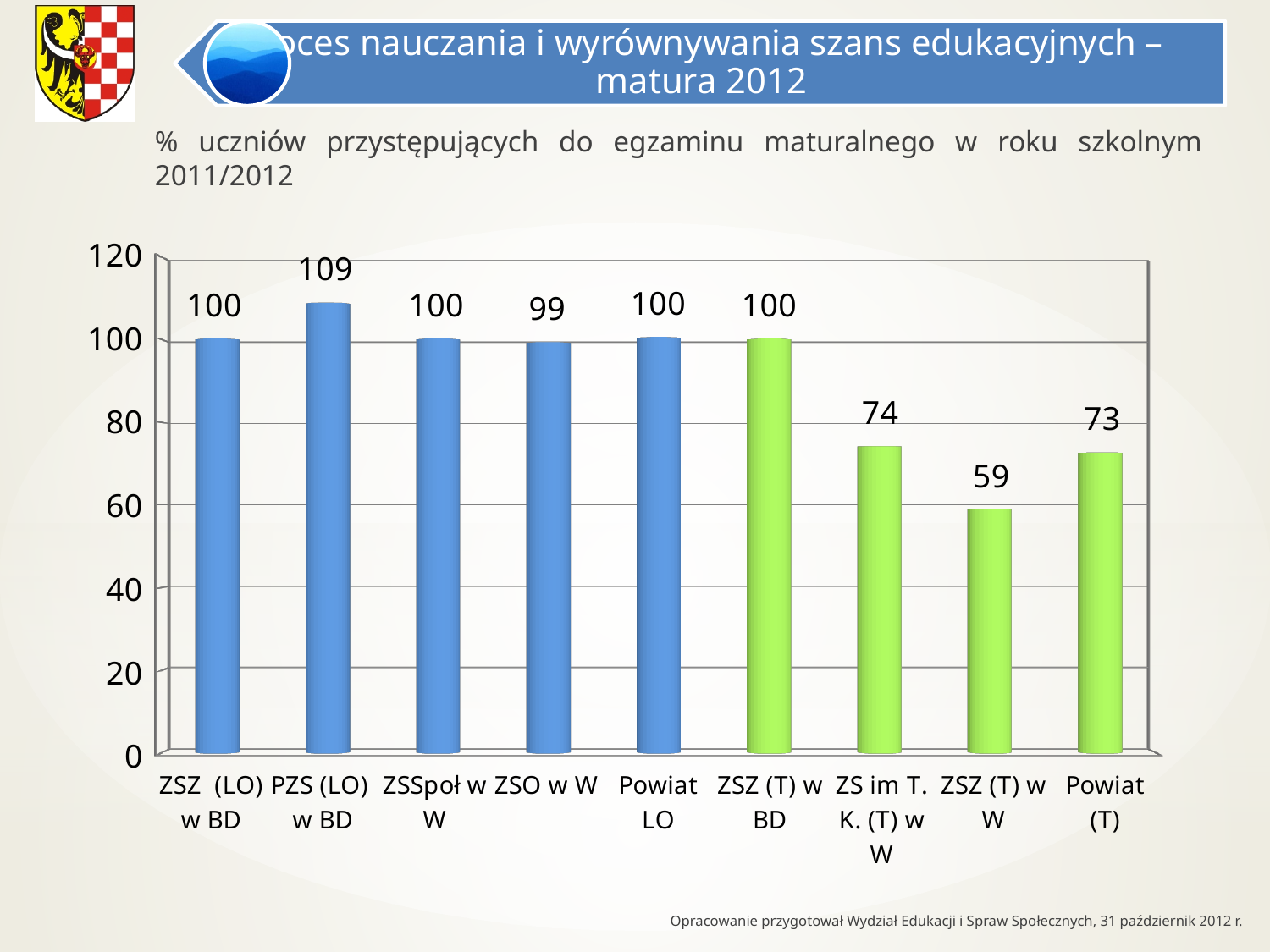
What is the value for ZSZ (T) w W? 59 Which category has the highest value? PZS (LO) w BD What is the difference between the values for PZS (LO) w BD and ZSZ (T) w W? 50 What kind of chart is shown on the slide? bar chart What is the value for ZS im T. K. (T) w W? 74 What is the value for ZSO w W? 99 Which category has the lowest value? ZSZ (T) w W What is the value for Powiat (T)? 73 How many categories are shown on the x axis? 9 Which is larger, the value for Powiat LO or the value for Powiat (T)? Powiat LO How many bars are coloured green? 4 What is the value for PZS (LO) w BD? 109